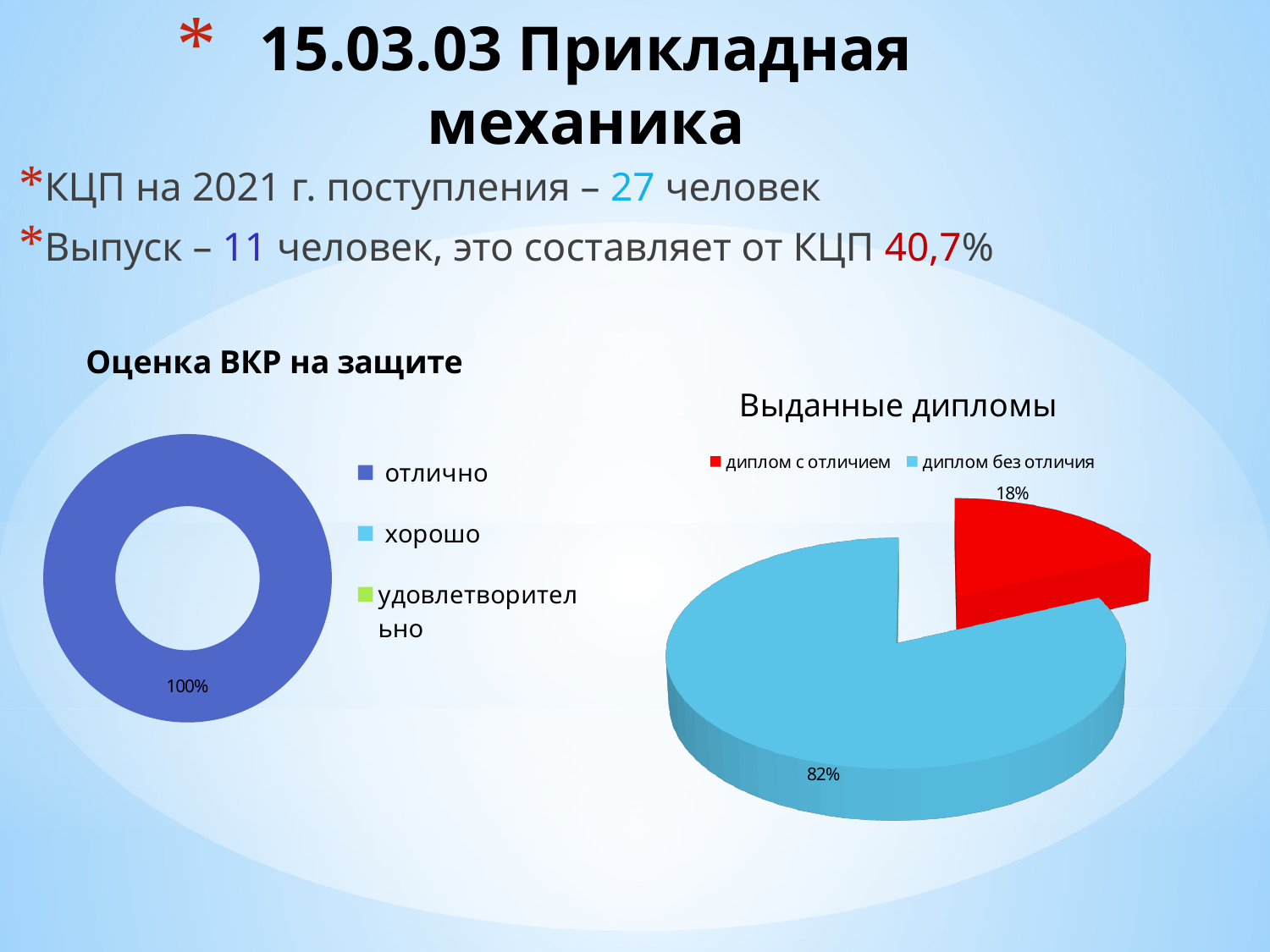
In the chart titled "Выданные дипломы", how many entries does the legend list? 2 In the chart titled "Выданные дипломы", what share is labelled for "диплом с отличием"? 18% In the chart titled "Выданные дипломы", what colour is the slice for "диплом с отличием"? red In the chart titled "Оценка ВКР на защите", what value is labelled on the chart? 100% In the chart titled "Выданные дипломы", which is larger: "диплом с отличием" or "диплом без отличия"? диплом без отличия What kind of chart is the chart titled "Выданные дипломы"? pie chart In the chart titled "Выданные дипломы", what is the difference in percentage points between "диплом без отличия" and "диплом с отличием"? 64 In the chart titled "Оценка ВКР на защите", how many entries does the legend list? 3 In the chart titled "Выданные дипломы", what share is labelled for "диплом без отличия"? 82% In the chart titled "Выданные дипломы", which category has the smallest slice? диплом с отличием In the chart titled "Выданные дипломы", which category has the largest slice? диплом без отличия In the chart titled "Оценка ВКР на защите", which legend category does the single 100% segment belong to? отлично